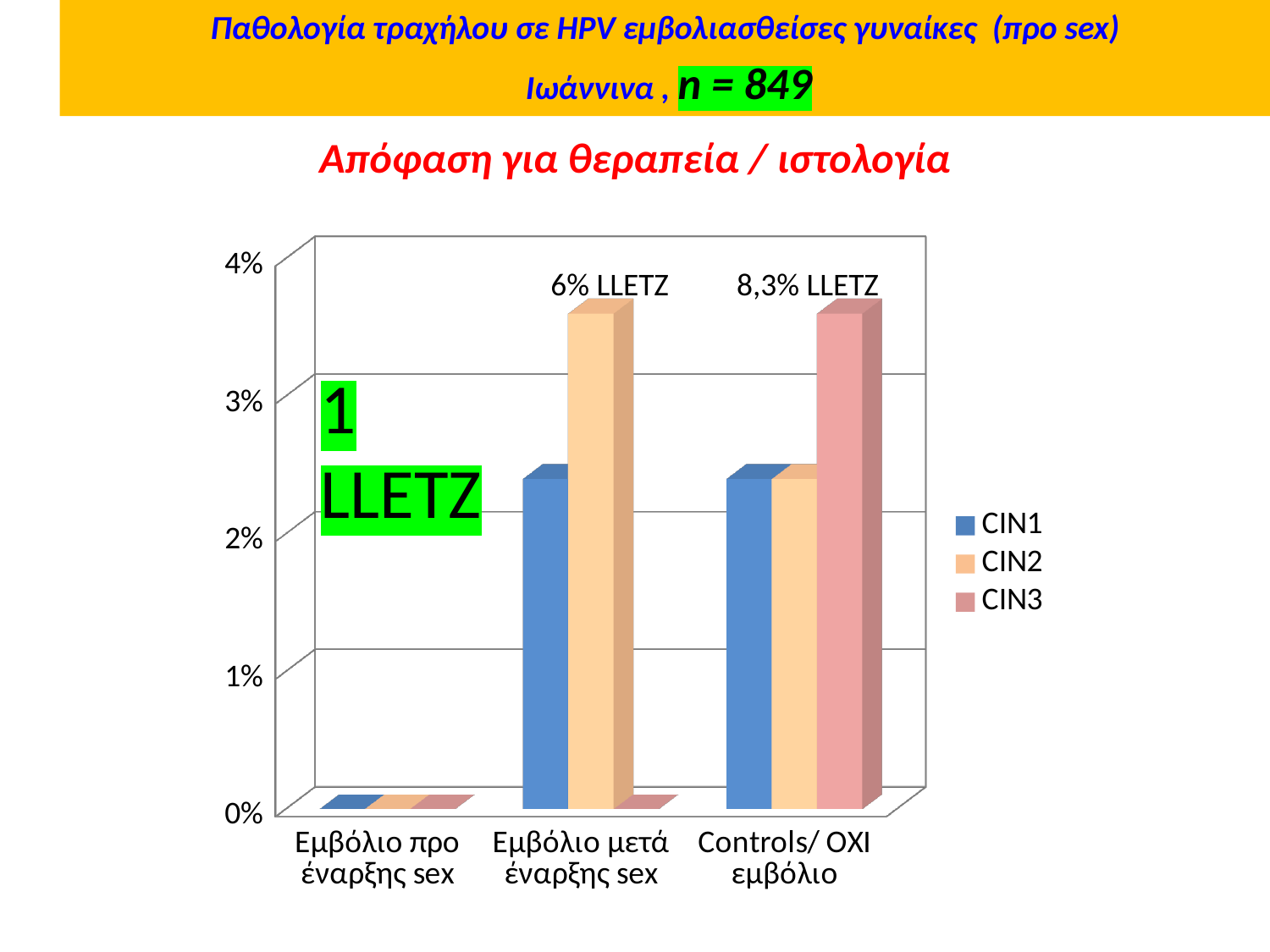
Is the CIN3 value for "Controls/ ΟΧΙ εμβόλιο" greater or less than 3%? greater Which category has the lowest values across all three series? Εμβόλιο προ έναρξης sex What annotation is printed above the "Controls/ ΟΧΙ εμβόλιο" group of bars? 8,3% LLETZ Is the CIN1 value for "Εμβόλιο μετά έναρξης sex" greater or less than 2%? greater What kind of chart is shown on the slide? bar chart In the "Εμβόλιο μετά έναρξης sex" category, which is larger: the CIN1 value or the CIN2 value? CIN2 How many series does the chart legend list? 3 Which series has the lowest value in the "Εμβόλιο μετά έναρξης sex" category? CIN3 Which series has the highest value in the "Controls/ ΟΧΙ εμβόλιο" category? CIN3 Which series has the highest value in the "Εμβόλιο μετά έναρξης sex" category? CIN2 Is the CIN2 value for "Εμβόλιο μετά έναρξης sex" greater or less than 3%? greater How many categories are shown on the x axis of the chart? 3